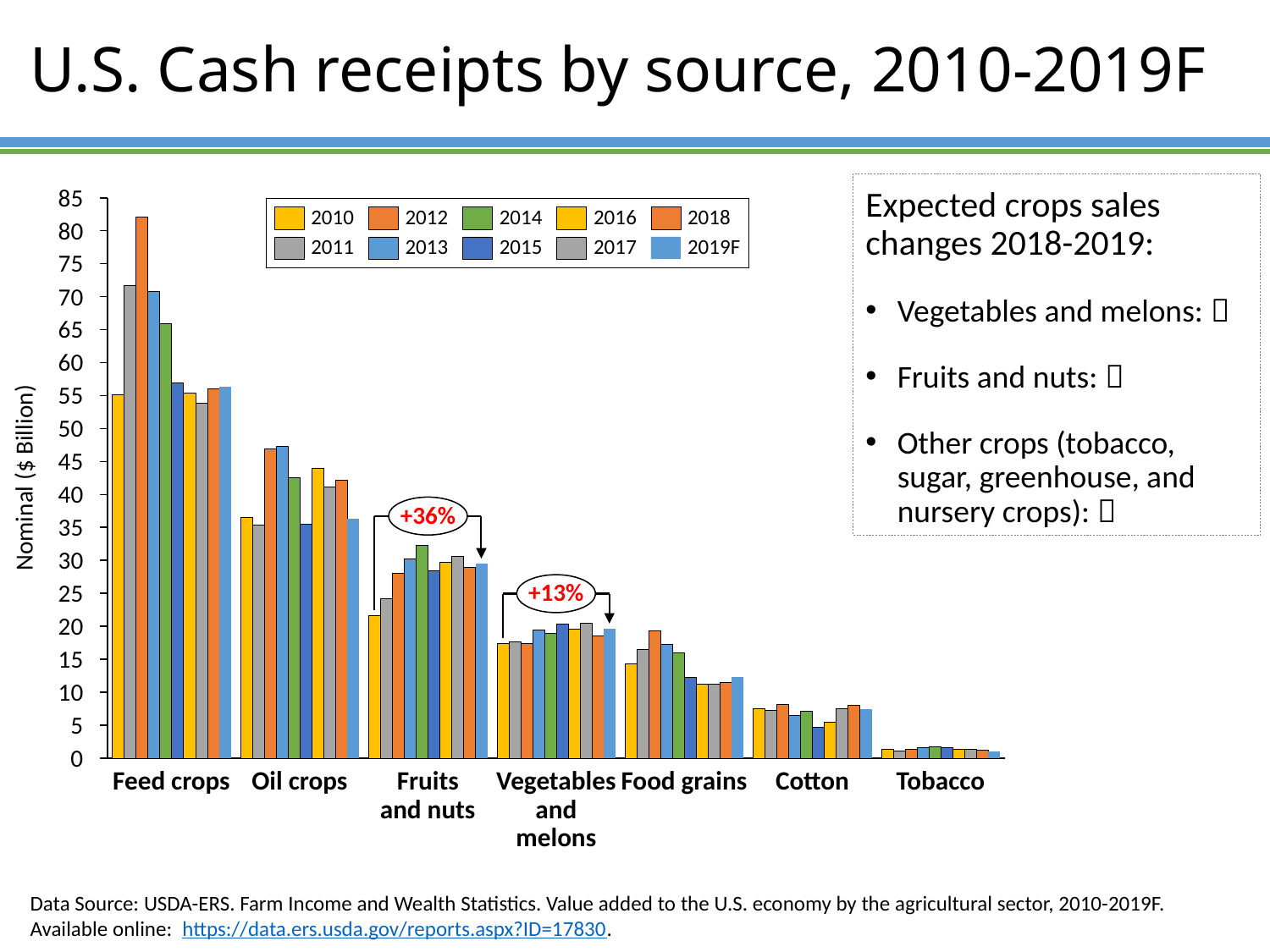
What percentage change is annotated for Fruits and nuts on the chart? +36% How many crop categories are shown on the x axis of the chart? 7 Which year has the highest value for Food grains? 2012 What percentage change is annotated for Vegetables and melons on the chart? +13% Is the value for Cotton in 2012 greater or less than 10? less What kind of chart is shown on the slide? bar chart What is the label of the vertical axis of the chart? Nominal ($ Billion) Which crop category has the lowest cash receipts in the chart? Tobacco How many series (years) does the chart legend list? 10 Which crop category has the highest cash receipts in the chart? Feed crops Is the value for Feed crops in 2012 greater or less than 80? greater Which is larger for Feed crops: the 2012 value or the 2011 value? 2012